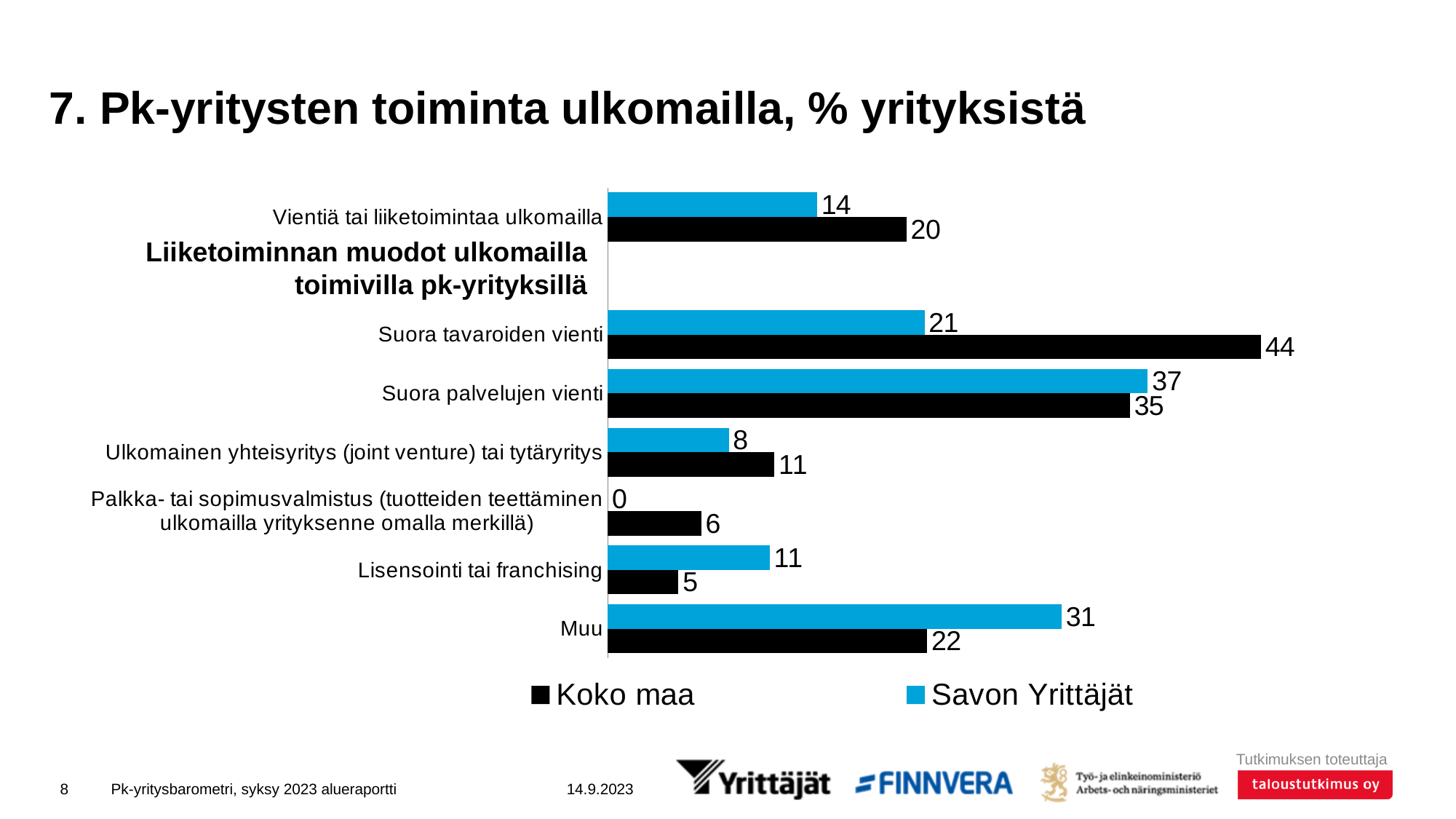
What kind of chart is shown on the slide? Bar chart How many series does the legend list? 2 What is the difference between the Koko maa and Savon Yrittäjät values for Suora tavaroiden vienti? 23 What is the value for Savon Yrittäjät for Suora palvelujen vienti? 37 Which colour represents Savon Yrittäjät in the chart? Blue What is the value for Savon Yrittäjät for Palkka- tai sopimusvalmistus (tuotteiden teettäminen ulkomailla yrityksenne omalla merkillä)? 0 How many categories are shown in the chart? 7 Which category has the highest value for Koko maa? Suora tavaroiden vienti Which category has the lowest value for Savon Yrittäjät? Palkka- tai sopimusvalmistus (tuotteiden teettäminen ulkomailla yrityksenne omalla merkillä) What is the value for Koko maa for Lisensointi tai franchising? 5 For Muu, which series has the larger value, Koko maa or Savon Yrittäjät? Savon Yrittäjät What is the value for Koko maa for Suora tavaroiden vienti? 44